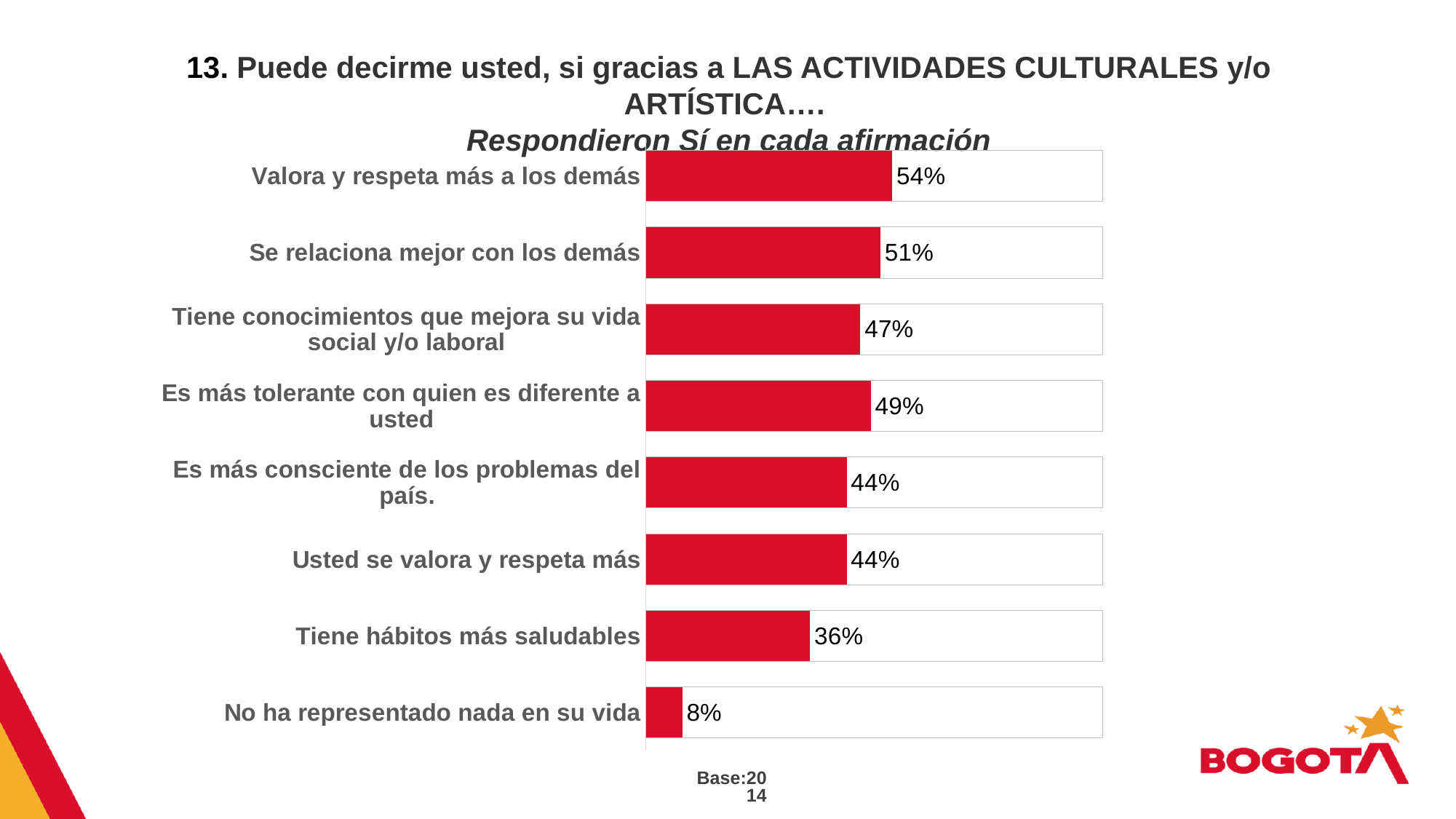
What base size is noted below the chart? Base:2014 Which two statements share the same value of 44%? Es más consciente de los problemas del país. and Usted se valora y respeta más What is the difference between "Se relaciona mejor con los demás" and "Tiene hábitos más saludables"? 15% What is the value for "Tiene hábitos más saludables"? 36% Which statement has the highest percentage? Valora y respeta más a los demás What is the difference between "Valora y respeta más a los demás" and "No ha representado nada en su vida"? 46% What kind of chart is shown on the slide? Bar chart Which statement has the lowest percentage? No ha representado nada en su vida Which is larger: "Tiene conocimientos que mejora su vida social y/o laboral" or "Es más tolerante con quien es diferente a usted"? Es más tolerante con quien es diferente a usted What percentage responded yes to "Valora y respeta más a los demás"? 54% What is the value for "Es más tolerante con quien es diferente a usted"? 49% How many statements are shown in the chart? 8